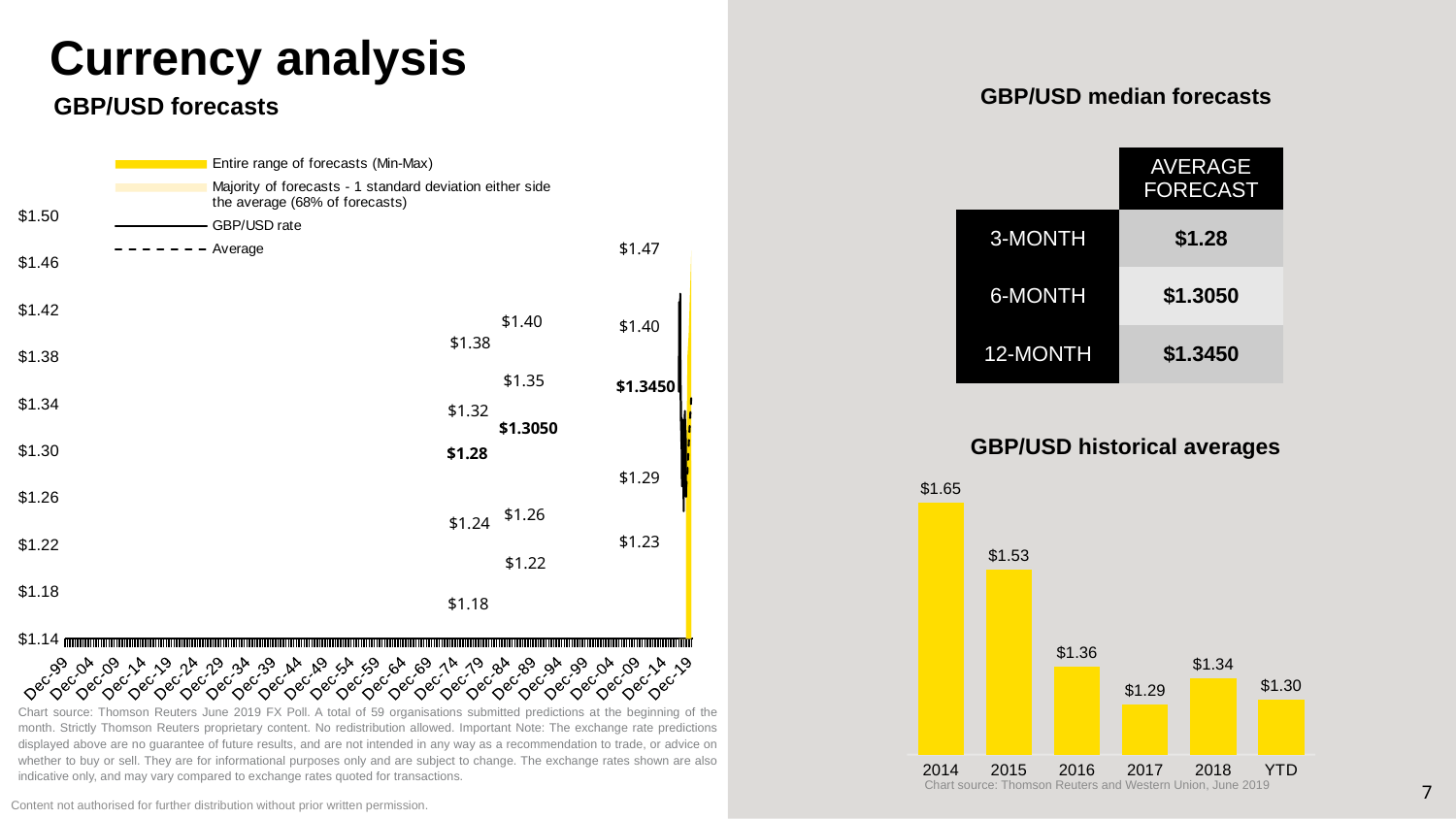
In the GBP/USD historical averages chart, which category has the lowest value? 2017 In the GBP/USD historical averages chart, what is the value for 2017? $1.29 In the GBP/USD historical averages chart, what is the value for YTD? $1.30 In the GBP/USD historical averages chart, which is larger, the value for 2016 or the value for 2018? 2016 In the GBP/USD historical averages chart, do the values generally rise or fall from 2014 to 2017? Fall In the GBP/USD historical averages chart, what is the difference between the 2018 and 2017 values? $0.05 In the GBP/USD historical averages chart, which year has the highest value? 2014 How many categories are shown in the GBP/USD historical averages chart? 6 How many entries does the legend of the GBP/USD forecasts chart list? 4 In the GBP/USD historical averages chart, what is the difference between the 2014 and 2015 values? $0.12 In the GBP/USD historical averages chart, what is the value for 2014? $1.65 What kind of chart is the GBP/USD historical averages chart? Bar chart